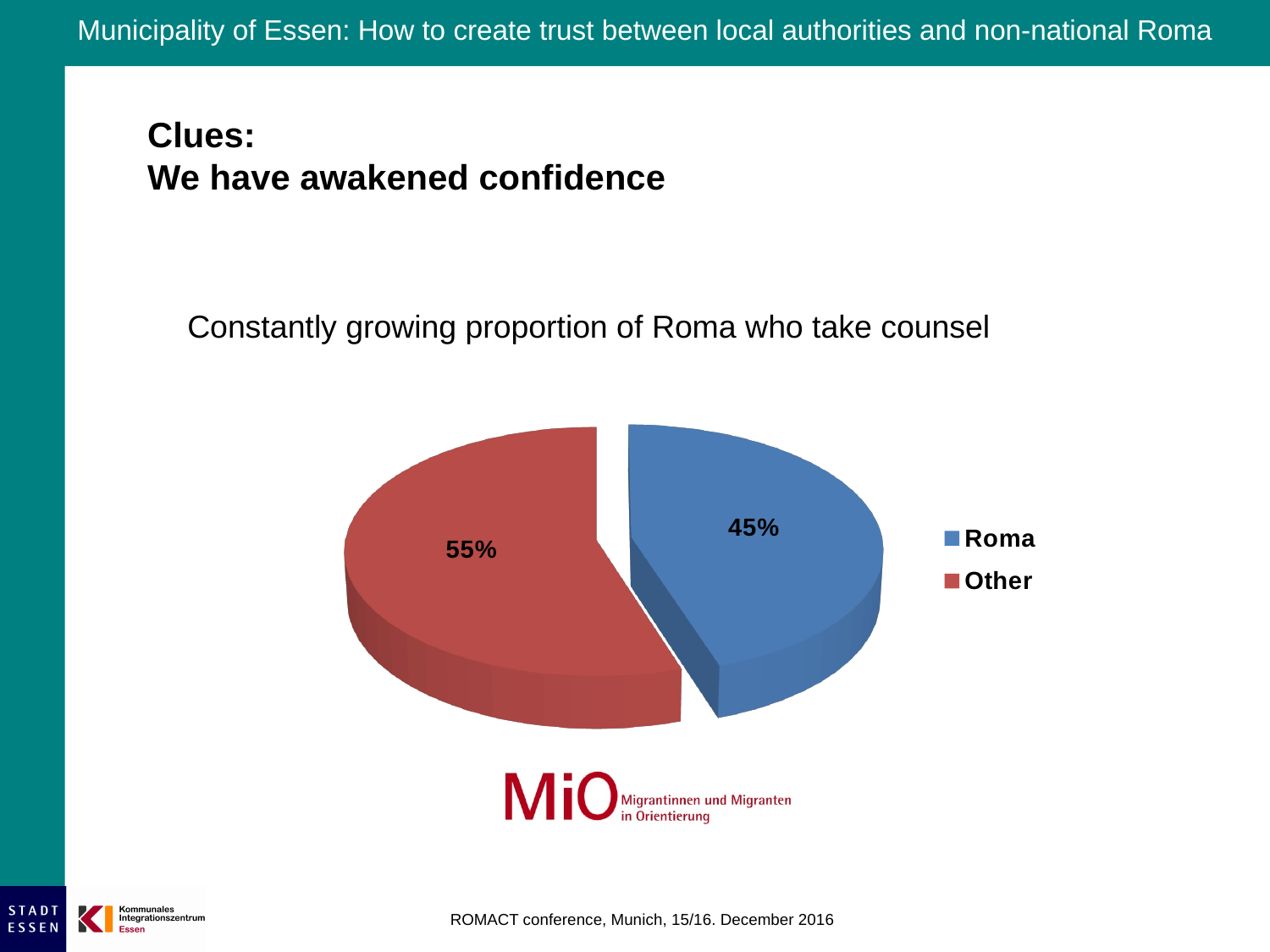
What kind of chart is shown on the slide? Pie chart Which slice of the pie chart is the smallest? Roma What is the difference in percentage points between the Other slice and the Roma slice? 10 How many slices does the pie chart have? 2 What colour is the Other slice in the pie chart? Red What percentage of the pie chart is labelled Other? 55% What percentage of the pie chart is labelled Roma? 45% How many entries does the legend list? 2 Which slice is larger, Roma or Other? Other What colour is the Roma slice in the pie chart? Blue Which slice of the pie chart is the largest? Other What share of the pie does the Roma slice represent? 45%